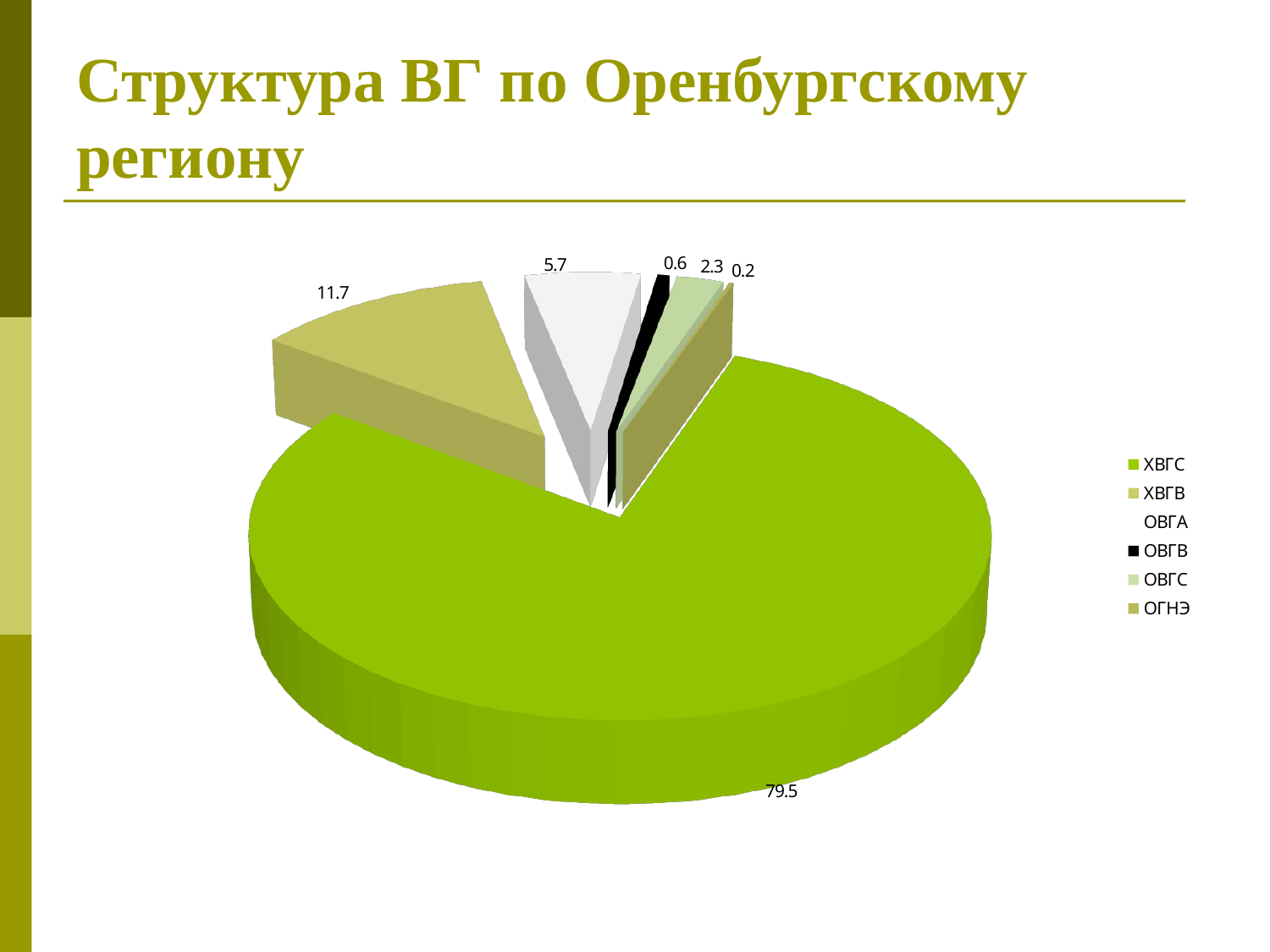
How many entries does the legend list? 6 What is the title of the chart slide? Структура ВГ по Оренбургскому региону Which category has the largest slice of the pie? ХВГС What is the value for ХВГС? 79.5 What is the value for ХВГВ? 11.7 Which category has the smallest slice of the pie? ОГНЭ What is the value for ОВГА? 5.7 What is the value for ОВГС? 2.3 What is the difference between the values for ХВГС and ХВГВ? 67.8 What type of chart is shown on the slide? pie chart What is the value for ОВГВ? 0.6 Which is larger, the value for ОВГА or the value for ОВГС? ОВГА